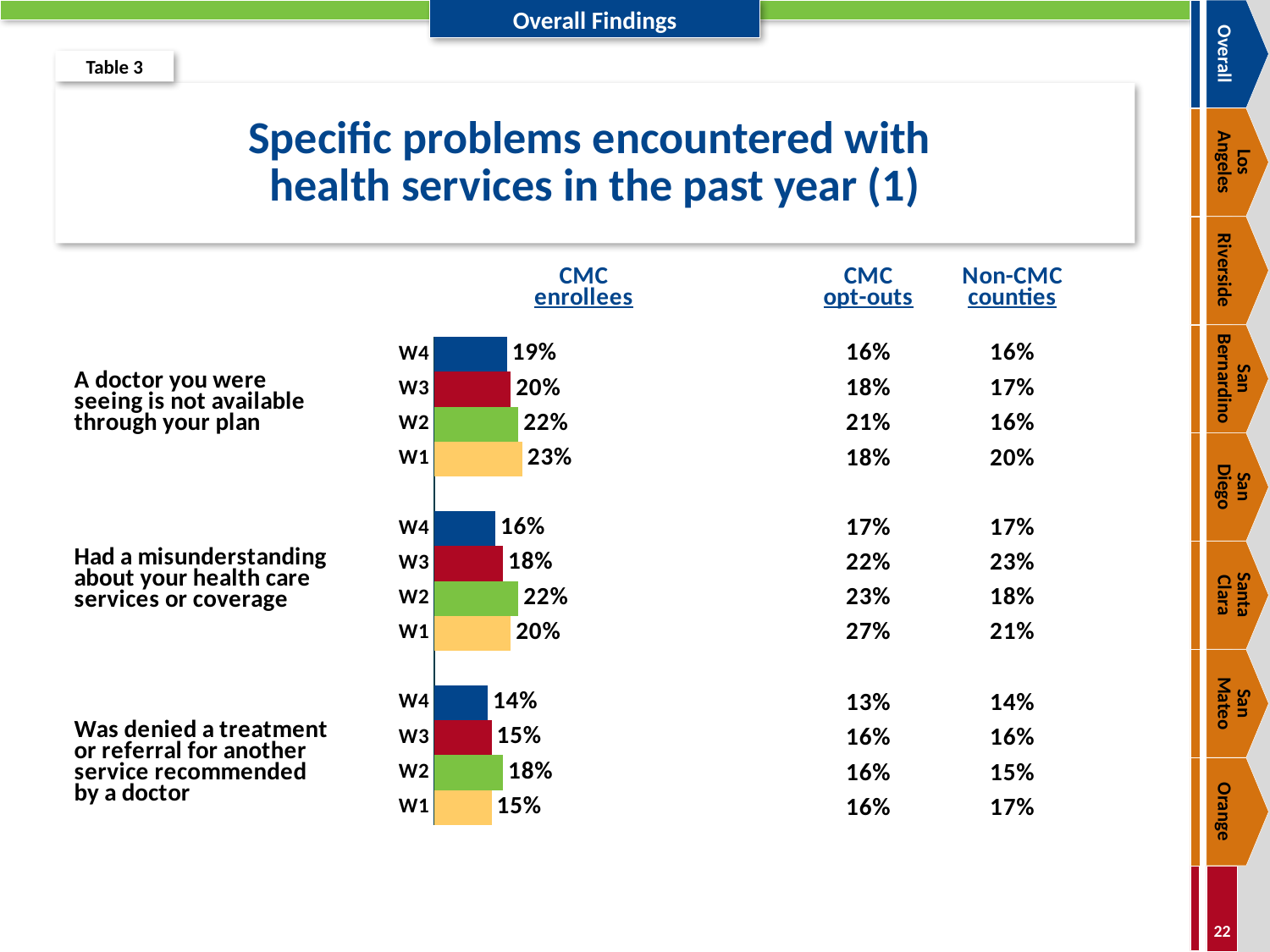
How many waves (bars) are shown for each problem in the CMC enrollees bar chart? 4 In the CMC enrollees bar chart, what colour are the W4 bars? Blue In the CMC enrollees bar chart, which wave has the highest value for 'A doctor you were seeing is not available through your plan'? W1 In the CMC enrollees bar chart, which wave has the highest value for 'Had a misunderstanding about your health care services or coverage'? W2 In the CMC enrollees bar chart, do the values for 'A doctor you were seeing is not available through your plan' rise or fall from W1 to W4? Fall What type of chart is used to show the CMC enrollees values? Bar chart In the CMC enrollees bar chart, what is the difference between the W1 and W4 values for 'A doctor you were seeing is not available through your plan'? 4 percentage points In the CMC enrollees bar chart, what is the W4 value for 'A doctor you were seeing is not available through your plan'? 19% In the CMC enrollees bar chart, which is larger for 'Had a misunderstanding about your health care services or coverage': W2 or W3? W2 In the CMC enrollees bar chart, which wave has the lowest value for 'Was denied a treatment or referral for another service recommended by a doctor'? W4 In the CMC enrollees bar chart, what is the W2 value for 'Was denied a treatment or referral for another service recommended by a doctor'? 18% In the CMC enrollees bar chart, what is the W1 value for 'Had a misunderstanding about your health care services or coverage'? 20%